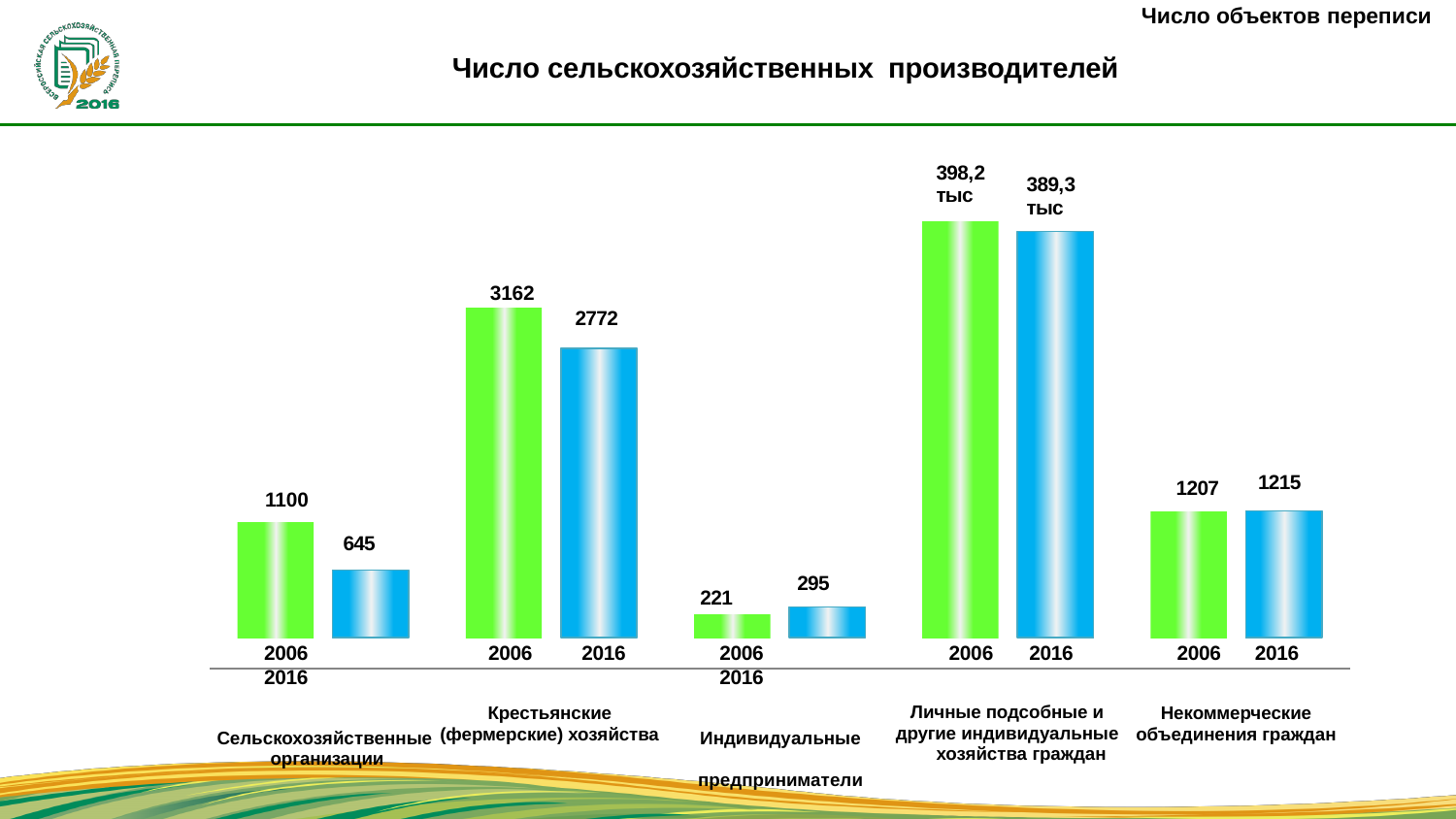
What type of chart is shown on the slide? Bar chart Which is larger for Индивидуальные предприниматели: the 2006 value or the 2016 value? 2016 Which category has the lowest value in 2006? Индивидуальные предприниматели What is the value for Сельскохозяйственные организации in 2006? 1100 What is the difference between the 2016 and 2006 values for Индивидуальные предприниматели? 74 What is the value for Личные подсобные и другие индивидуальные хозяйства граждан in 2006? 398,2 тыс What is the value for Сельскохозяйственные организации in 2016? 645 What is the value for Крестьянские (фермерские) хозяйства in 2016? 2772 How many categories are shown on the chart? 5 What is the difference between the 2006 and 2016 values for Крестьянские (фермерские) хозяйства? 390 What is the value for Некоммерческие объединения граждан in 2016? 1215 Which is larger for Сельскохозяйственные организации: the 2006 value or the 2016 value? 2006